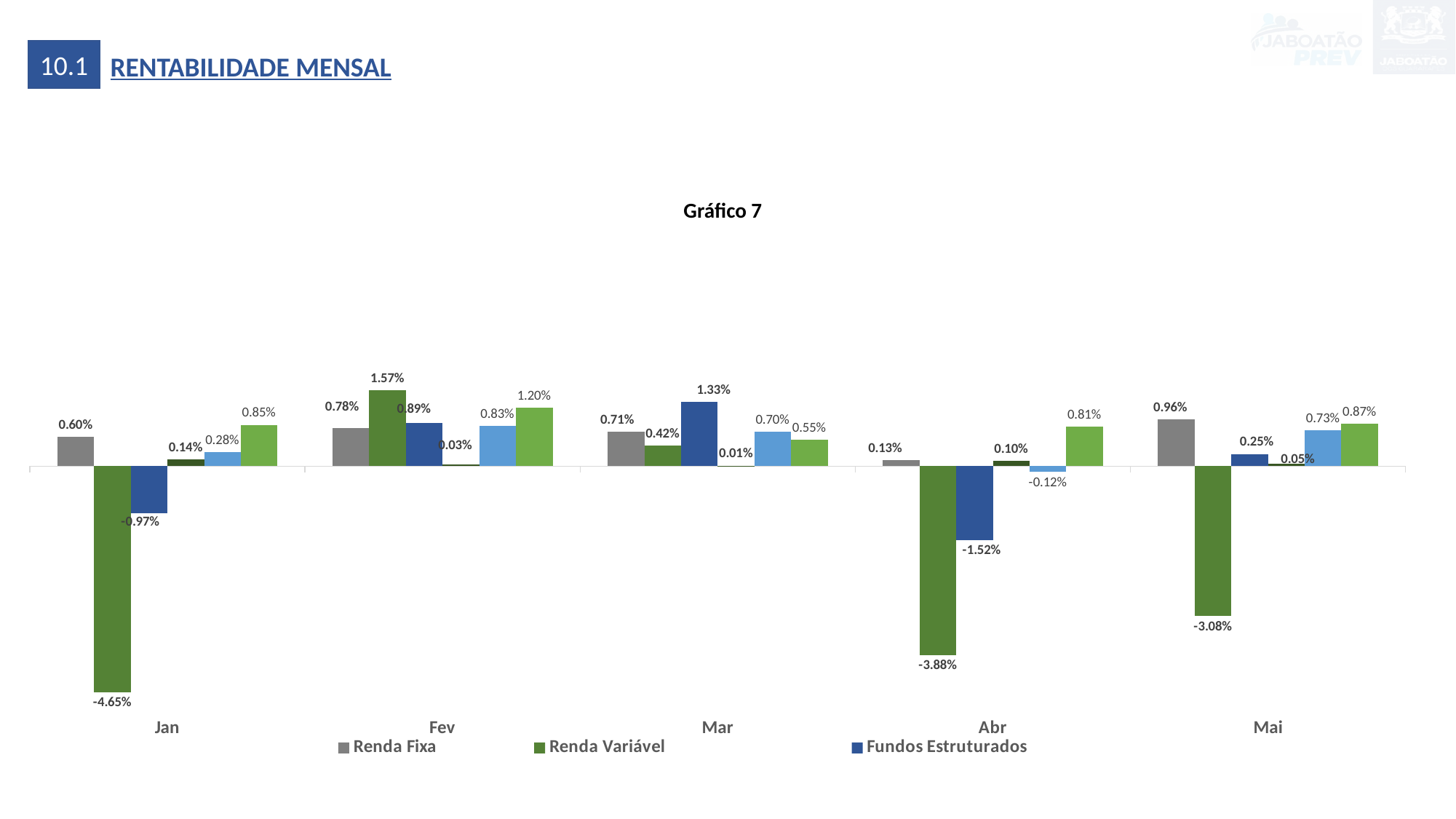
What is the value for Fundos Estruturados in Mar? 1.33% Which is larger in Mar, Renda Fixa or Renda Variável? Renda Fixa What is the difference between Renda Variável and Renda Fixa in Fev? 0.79% What kind of chart is shown on the slide? Bar chart In which month is Renda Variável lowest? Jan In which month is Fundos Estruturados lowest? Abr What is the value for Renda Variável in Abr? -3.88% What is the value for Fundos Estruturados in Mai? 0.25% How many series does the legend list? 3 In which month is Renda Fixa highest? Mai How many months are shown on the x axis? 5 What is the value for Renda Fixa in Jan? 0.60%